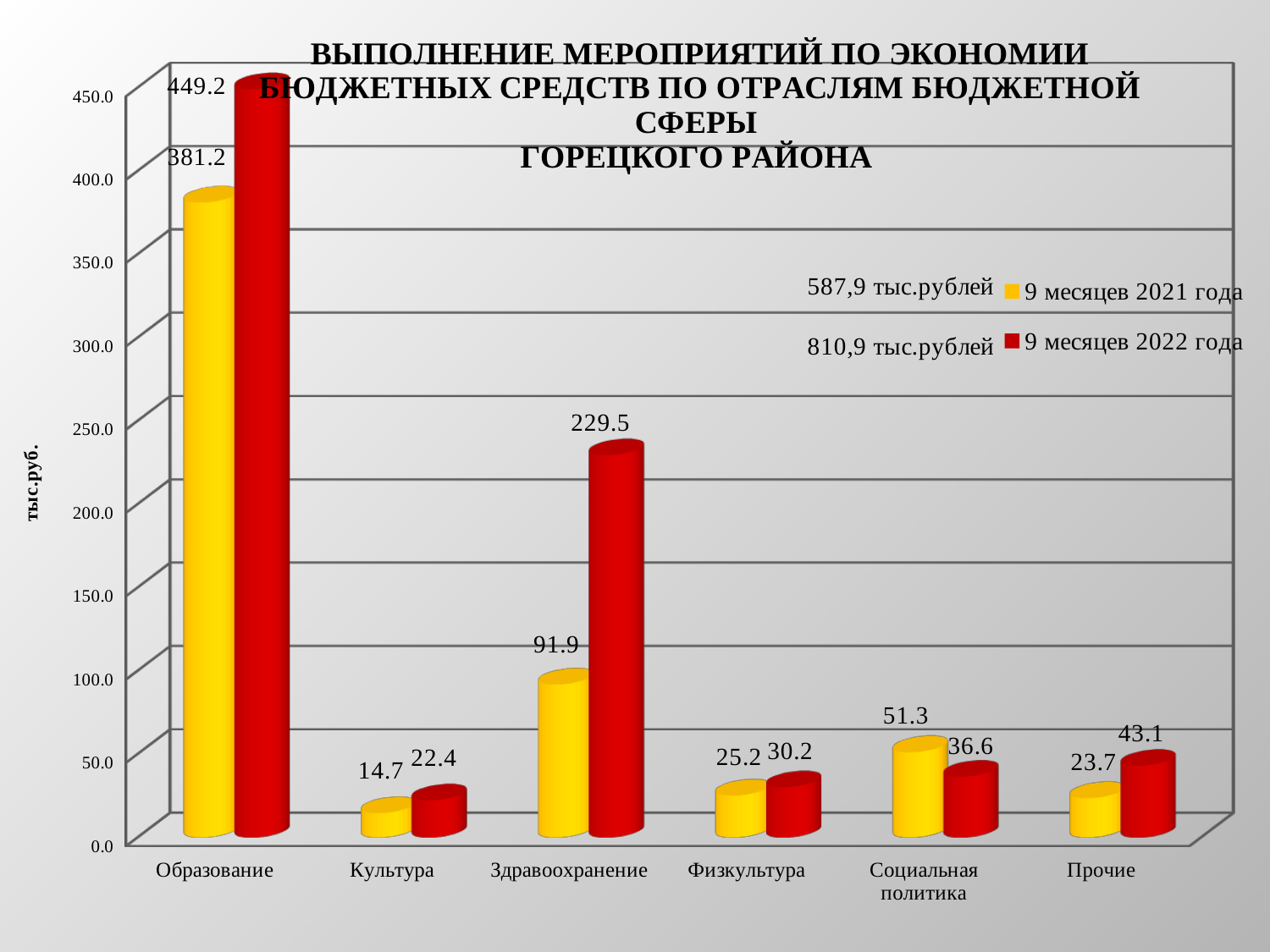
What is the value for Здравоохранение in the series 9 месяцев 2021 года? 91.9 What is the difference between the 9 месяцев 2022 года and 9 месяцев 2021 года values for Прочие? 19.4 What is the difference between the 9 месяцев 2022 года and 9 месяцев 2021 года values for Здравоохранение? 137.6 How many series does the legend list? 2 Which category has the lowest value in the series 9 месяцев 2022 года? Культура What is the value for Образование in the series 9 месяцев 2022 года? 449.2 Which category has the highest value in the series 9 месяцев 2021 года? Образование What kind of chart is shown on the slide? Bar chart What colour represents the series 9 месяцев 2022 года? Red How many categories are shown on the x axis? 6 For Социальная политика, which series has the larger value: 9 месяцев 2021 года or 9 месяцев 2022 года? 9 месяцев 2021 года What is the value for Социальная политика in the series 9 месяцев 2022 года? 36.6